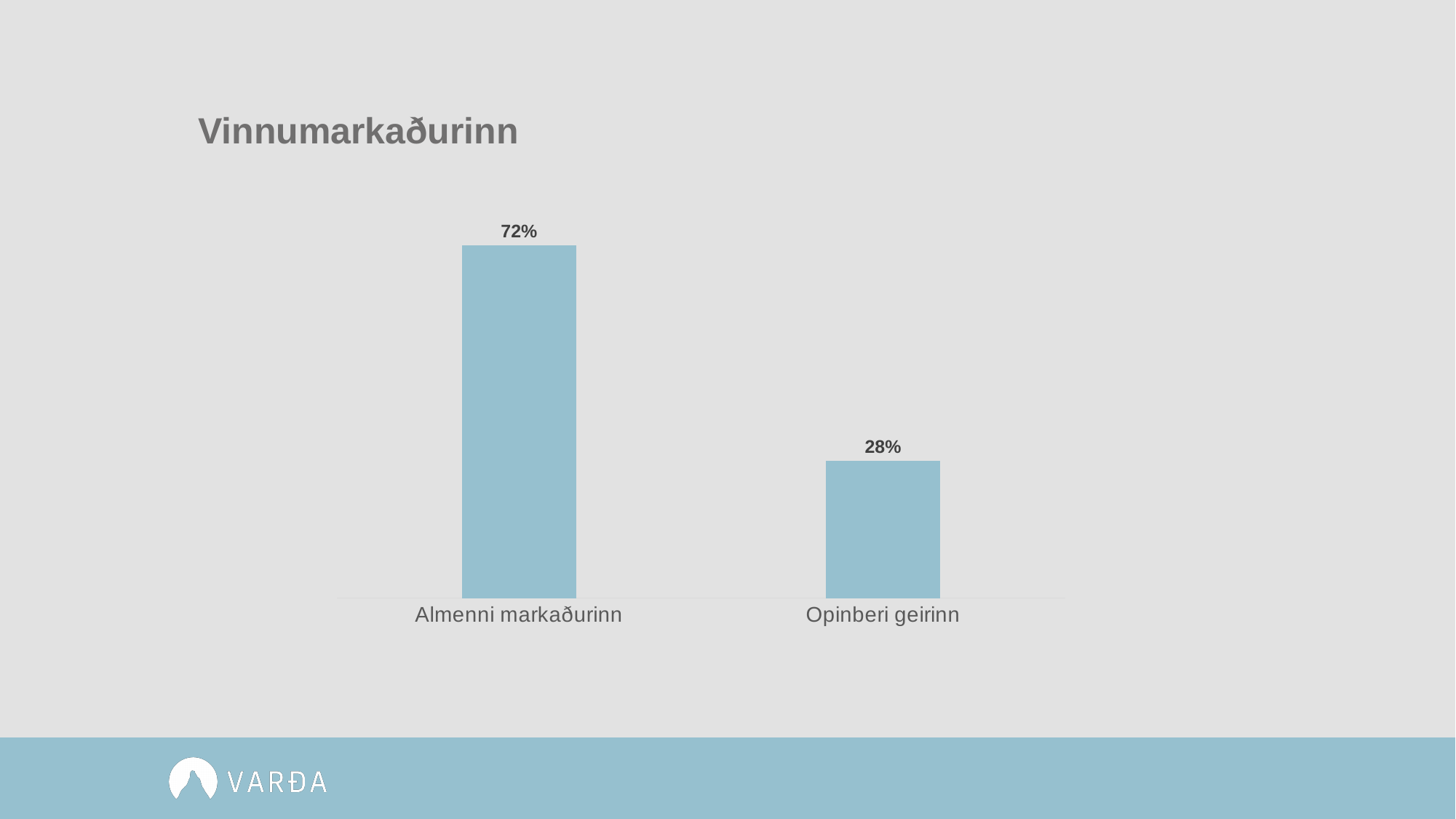
What is the total of the two values shown in the chart? 100% What is the value for Almenni markaðurinn? 72% Do the values rise or fall from left to right across the categories? Fall Which category has the lowest value? Opinberi geirinn What is the title of the chart? Vinnumarkaðurinn Which category has the highest value? Almenni markaðurinn How many categories are shown in the chart? 2 Which is larger, the value for Almenni markaðurinn or the value for Opinberi geirinn? Almenni markaðurinn What is the difference between the values for Almenni markaðurinn and Opinberi geirinn? 44% What is the value for Opinberi geirinn? 28% What kind of chart is shown on the slide? Bar chart